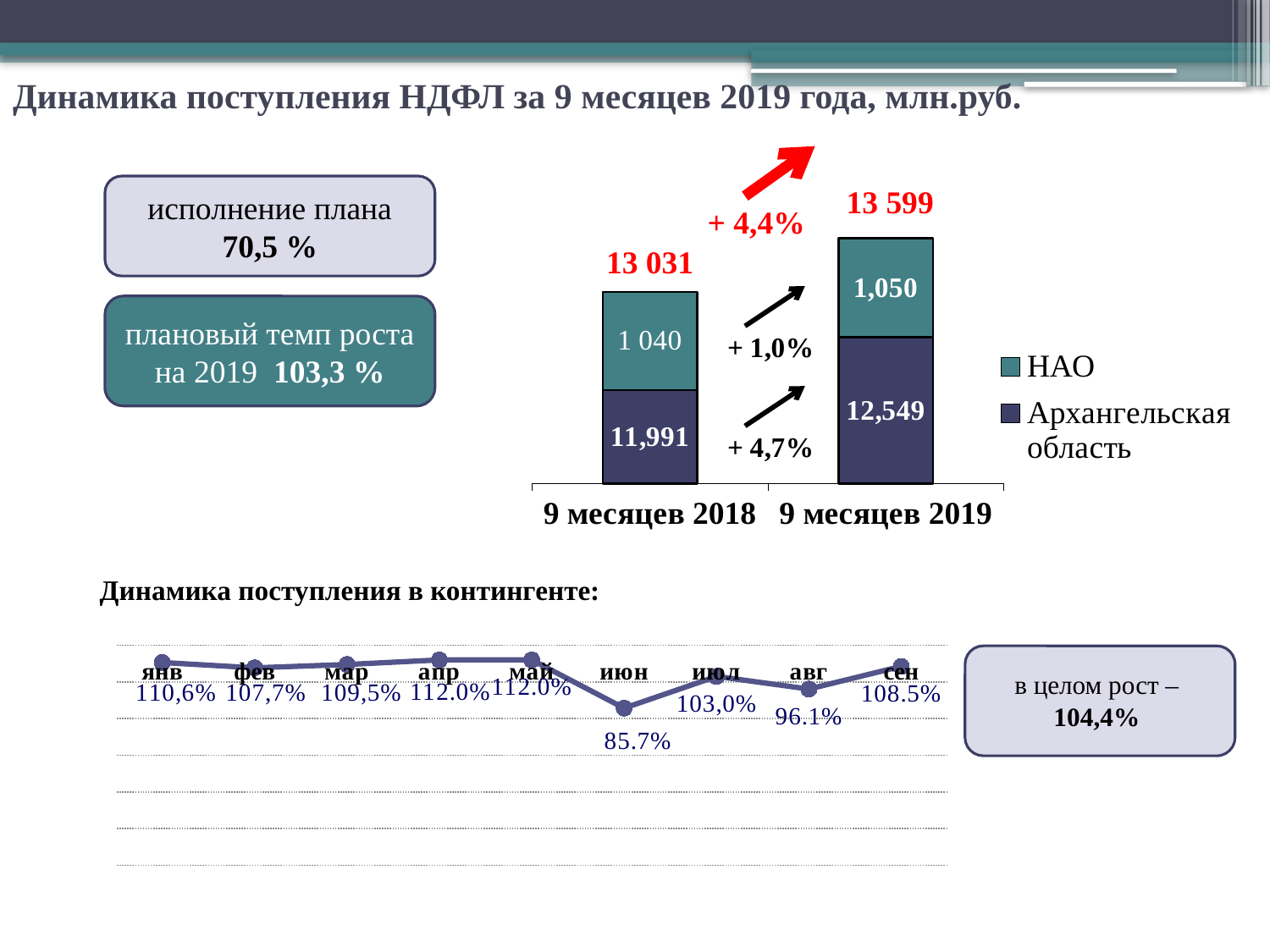
In the stacked bar chart, what is the value for НАО for 9 месяцев 2018? 1 040 In the line chart 'Динамика поступления в контингенте', which is larger, the value for июл or the value for авг? июл In the line chart 'Динамика поступления в контингенте', what is the value for июн? 85.7% In the line chart 'Динамика поступления в контингенте', which month has the lowest value? июн In the stacked bar chart, what is the total of the 9 месяцев 2018 bar? 13 031 In the stacked bar chart, what is the value for Архангельская область for 9 месяцев 2019? 12,549 In the stacked bar chart, which series is larger in the 9 месяцев 2019 bar, НАО or Архангельская область? Архангельская область In the line chart 'Динамика поступления в контингенте', how many months are plotted? 9 In the stacked bar chart, what is the total of the 9 месяцев 2019 bar? 13 599 What kind of chart is the top chart on the slide? stacked bar chart In the line chart 'Динамика поступления в контингенте', what is the value for янв? 110,6% In the stacked bar chart, how many series does the legend list? 2